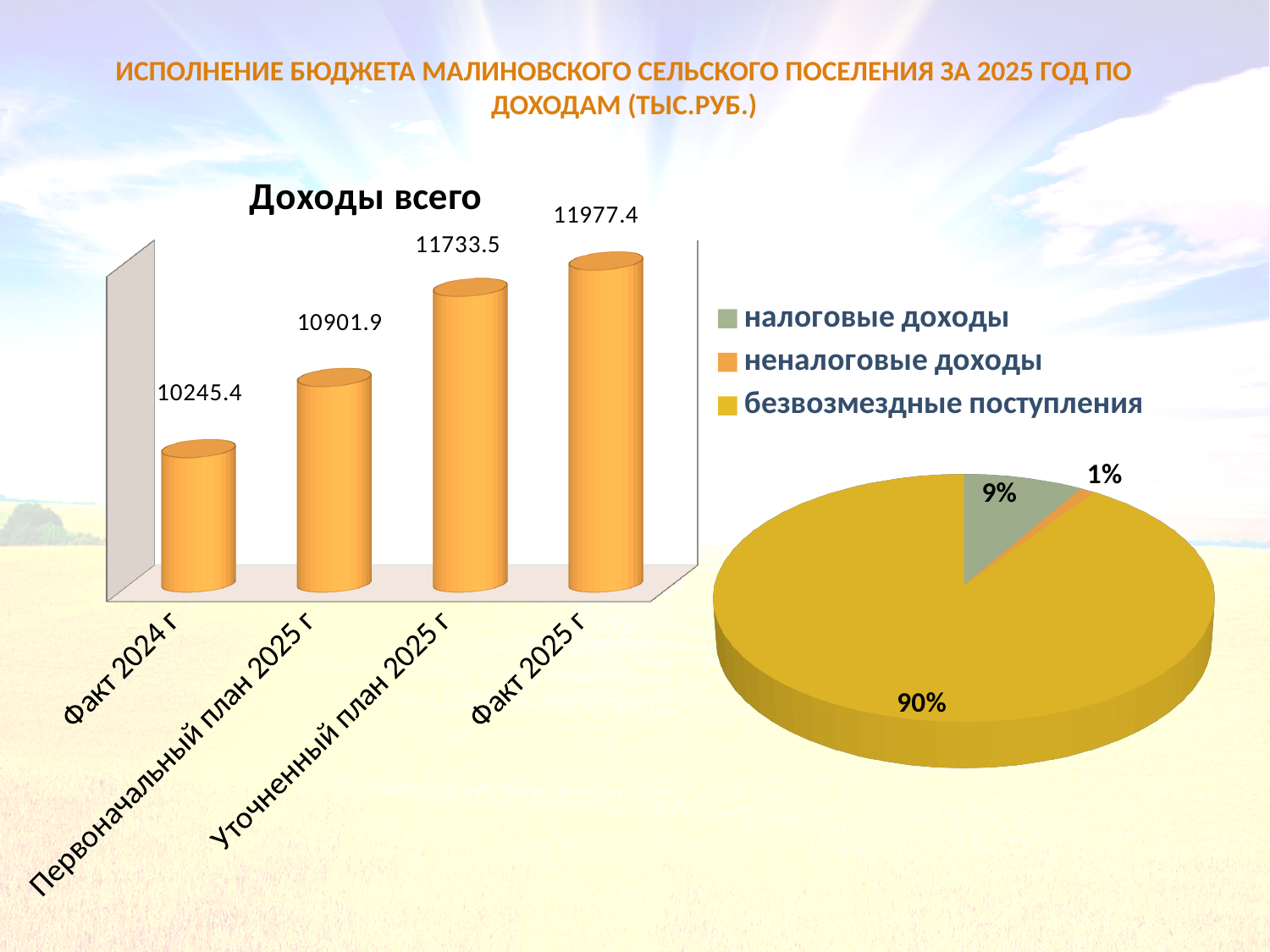
How many categories are shown in the 'Доходы всего' chart? 4 In the pie chart on the right, what share is 'налоговые доходы'? 9% How many entries does the legend of the pie chart on the right list? 3 What kind of chart is 'Доходы всего'? bar chart In the 'Доходы всего' chart, which is larger: 'Первоначальный план 2025 г' or 'Уточненный план 2025 г'? Уточненный план 2025 г In the 'Доходы всего' chart, which category has the highest value? Факт 2025 г In the 'Доходы всего' chart, what is the value for 'Уточненный план 2025 г'? 11733.5 In the pie chart on the right, what share is 'безвозмездные поступления'? 90% In the 'Доходы всего' chart, what is the difference between 'Факт 2025 г' and 'Факт 2024 г'? 1732 In the 'Доходы всего' chart, what is the value for 'Факт 2024 г'? 10245.4 In the 'Доходы всего' chart, do the values rise or fall from left to right? rise In the 'Доходы всего' chart, which category has the lowest value? Факт 2024 г